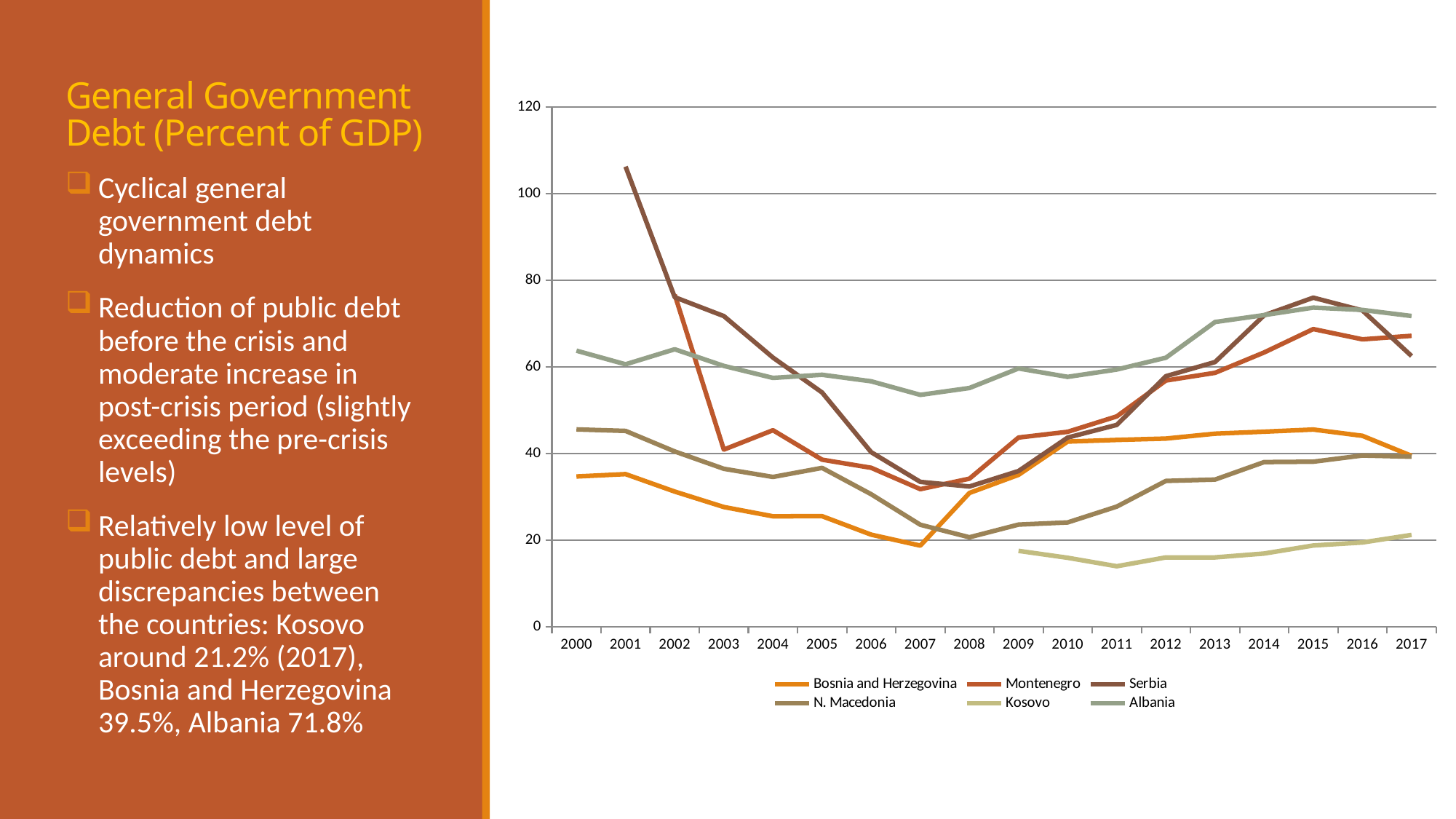
How many years are shown on the x axis? 18 Does the Kosovo line rise or fall from 2011 to 2017? rise In 2017, which is larger: the value for Albania or the value for Bosnia and Herzegovina? Albania Which country has the lowest debt in 2017? Kosovo Is the value for Kosovo in 2011 greater or less than 20? less Which country has the highest debt in 2001? Serbia Is the value for Serbia in 2001 greater or less than 100? greater How many series does the legend list? 6 In which year does the Kosovo series first appear on the chart? 2009 Is the value for Montenegro in 2003 greater or less than 60? less Does the Bosnia and Herzegovina line rise or fall from 2000 to 2007? fall What kind of chart is shown on the slide? line chart